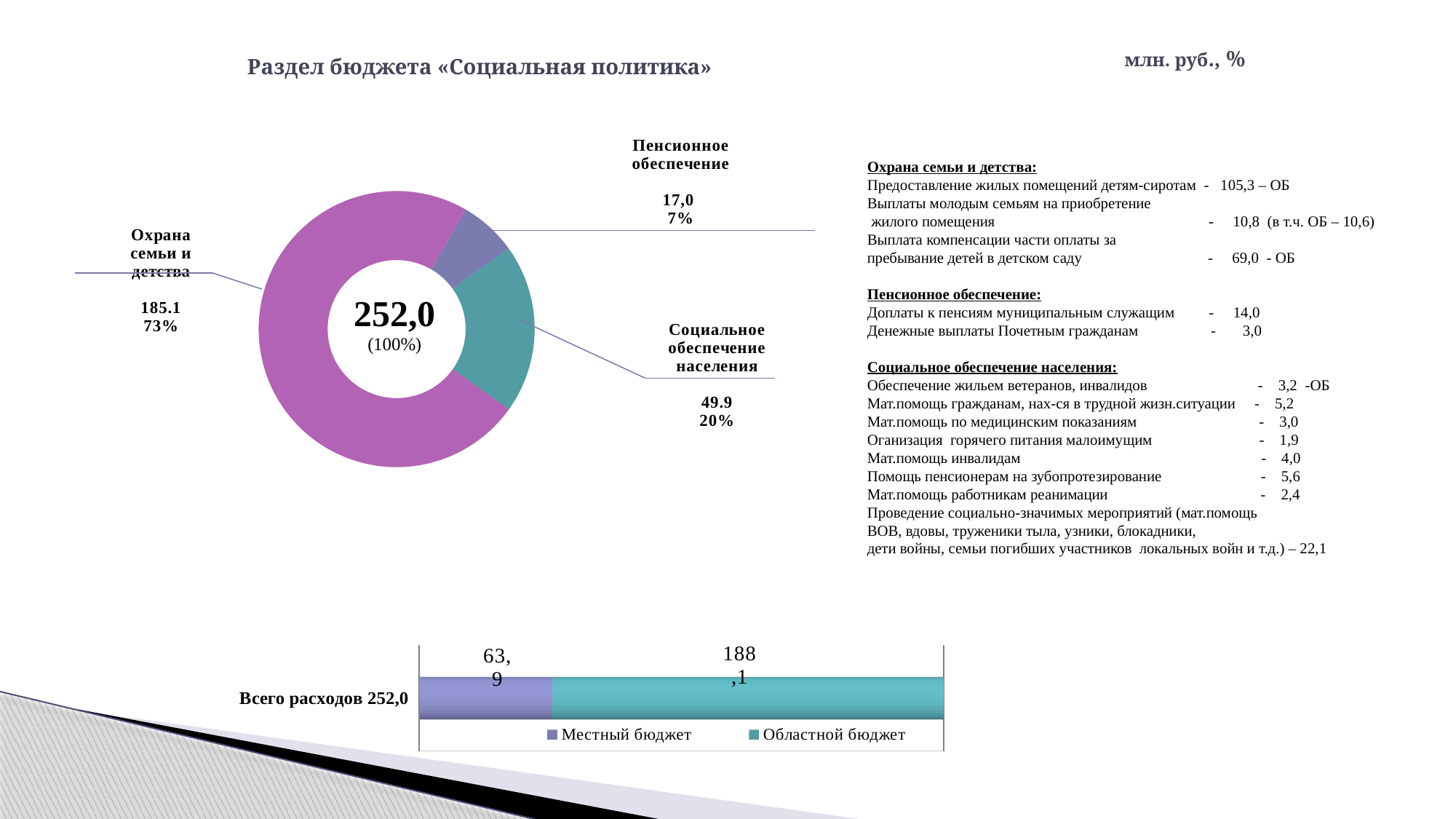
How many series does the legend of the bottom bar chart list? 2 In the donut chart, what is the value for «Охрана семьи и детства»? 185.1 In the donut chart, what is the value for «Пенсионное обеспечение»? 17,0 In the donut chart, which is larger: «Социальное обеспечение населения» or «Пенсионное обеспечение»? Социальное обеспечение населения In the bottom bar chart, what is the value for «Областной бюджет»? 188,1 In the bottom bar chart, what is the value for «Местный бюджет»? 63,9 What type of chart is shown at the bottom of the slide? Stacked bar chart In the donut chart, which category has the largest share? Охрана семьи и детства How many segments does the donut chart have? 3 In the donut chart, which category has the smallest share? Пенсионное обеспечение In the donut chart, what total value is shown in the centre? 252,0 In the donut chart, what share of the total does «Социальное обеспечение населения» represent? 20%